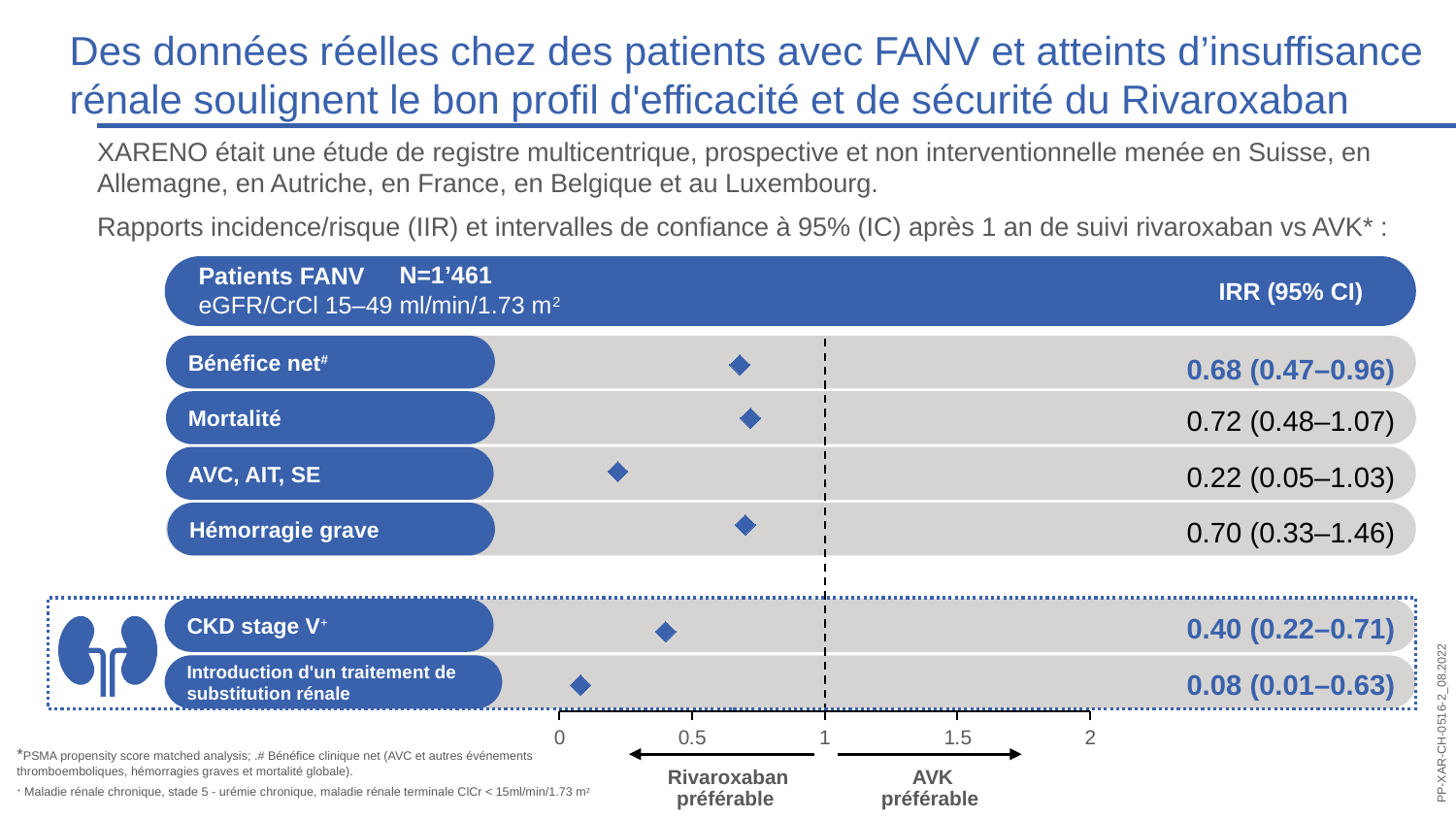
What is the IRR (95% CI) for CKD stage V? 0.40 (0.22–0.71) Is the IRR point estimate for CKD stage V greater or less than 0.5? less Which outcome has the highest IRR point estimate? Mortalité How many outcomes are plotted on the chart? 6 What is the number of patients (N) shown in the header of the chart? N=1'461 What is the IRR (95% CI) for Introduction d'un traitement de substitution rénale? 0.08 (0.01–0.63) What is the difference between the IRR point estimates for Mortalité and AVC, AIT, SE? 0.50 What is the IRR (95% CI) for AVC, AIT, SE? 0.22 (0.05–1.03) What is the IRR (95% CI) for Bénéfice net? 0.68 (0.47–0.96) What is the IRR (95% CI) for Mortalité? 0.72 (0.48–1.07) What is the IRR (95% CI) for Hémorragie grave? 0.70 (0.33–1.46) Which outcome has the lowest IRR point estimate? Introduction d'un traitement de substitution rénale